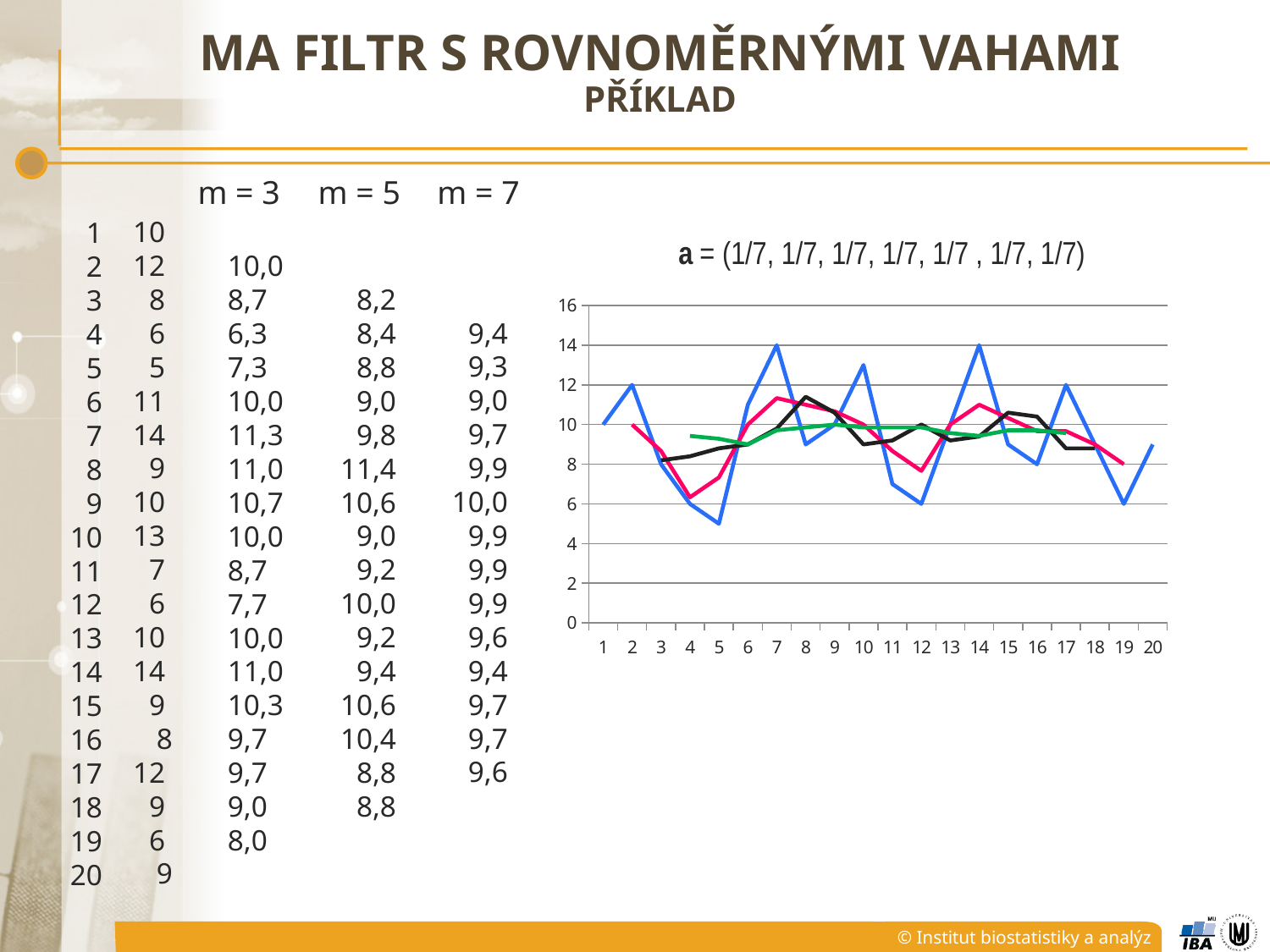
What kind of chart is shown on the slide? line chart What is the highest tick value shown on the y axis of the chart? 16 What is the highest value reached by the blue line? 14 Is the value of the blue line at x = 5 greater or less than 6? less What is the value of the blue line at x = 12? 6 How many lines are plotted on the chart? 4 Is the value of the blue line at x = 10 greater or less than 12? greater At which x value does the blue line reach its lowest point? 5 Which is larger on the blue line: the value at x = 7 or the value at x = 8? x = 7 What is the value of the blue line at x = 2? 12 How many points are marked along the x axis of the chart? 20 What is the value of the blue line at x = 7? 14